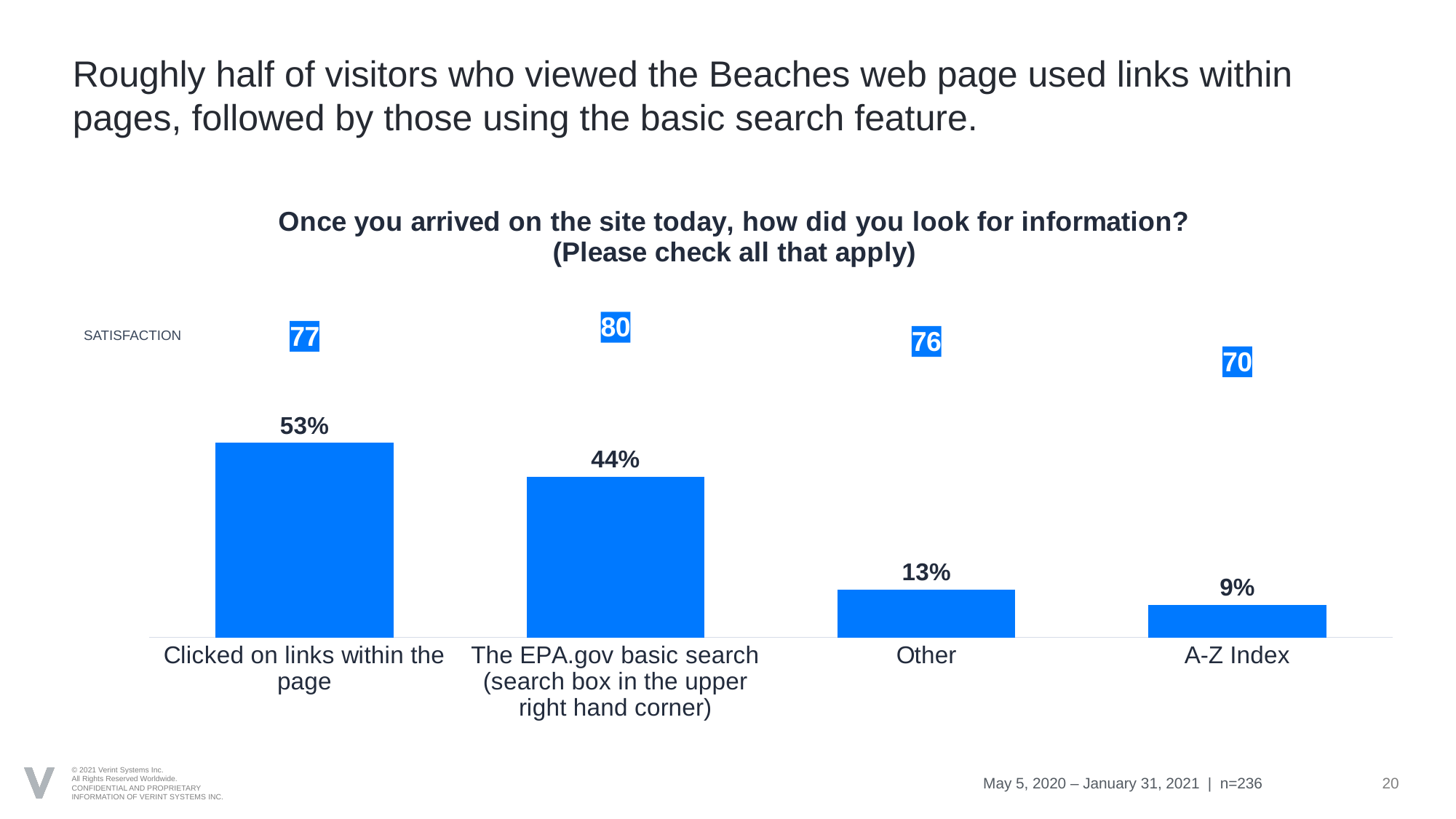
What percentage of visitors used the EPA.gov basic search? 44% How many categories are shown in the chart? 4 Which category has the highest satisfaction score? The EPA.gov basic search (search box in the upper right hand corner) Which is larger: the percentage for 'Other' or for 'A-Z Index'? Other Which method of looking for information has the highest percentage? Clicked on links within the page What is the difference in percentage between 'Clicked on links within the page' and 'The EPA.gov basic search'? 9% What percentage of visitors clicked on links within the page? 53% What is the sample size (n) shown at the bottom of the slide? n=236 What is the satisfaction score shown above the 'Other' bar? 76 What percentage of visitors used the A-Z Index? 9% Which method of looking for information has the lowest percentage? A-Z Index What kind of chart is shown on the slide? Bar chart